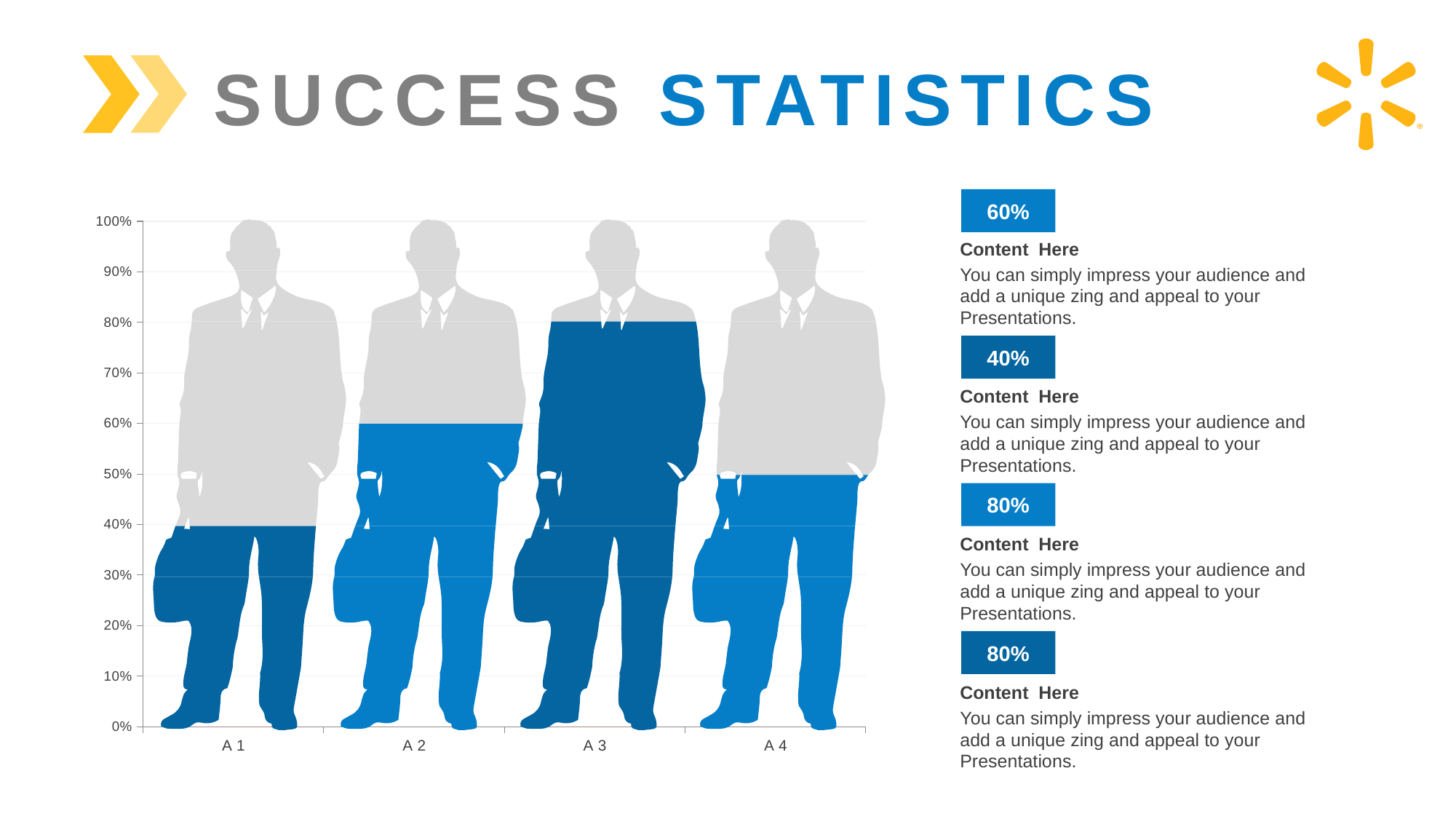
What kind of chart is this? bar chart What is the maximum value shown on the y axis? 100% What is the value for A 3? 80% Which is larger, the value for A 2 or the value for A 4? A 2 Which category has the highest value? A 3 Is the value for A 3 greater or less than 70%? greater Which category has the lowest value? A 1 What is the difference between the values for A 3 and A 1? 40% What is the value for A 1? 40% How many categories are shown on the x axis? 4 What is the value for A 2? 60% What is the value for A 4? 50%